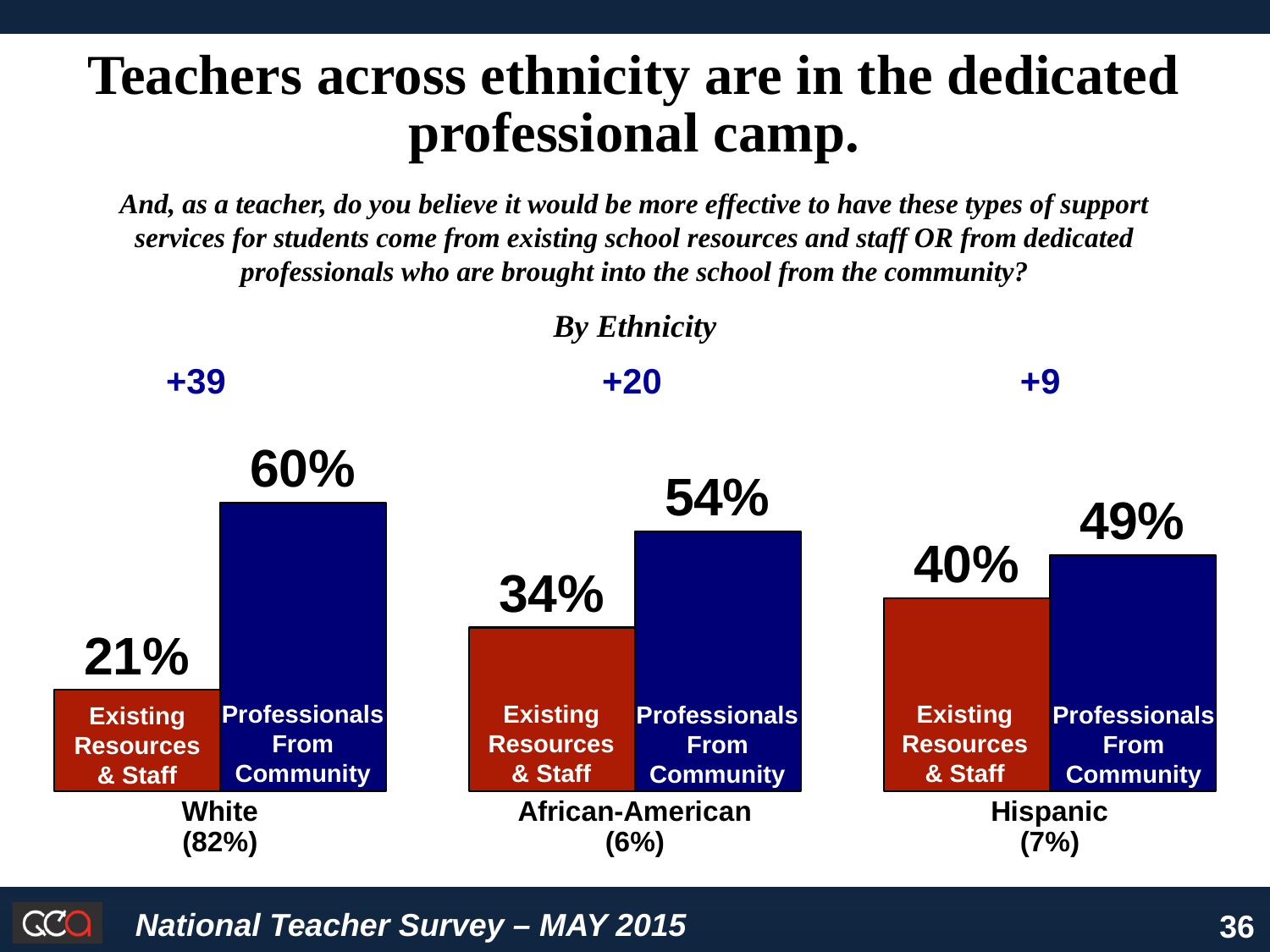
Which ethnicity group has the highest value for Professionals From Community? White What kind of chart is shown on the slide? Bar chart What percentage of African-American teachers chose Existing Resources & Staff? 34% How many ethnicity groups are shown in the chart? 3 What is the difference between Professionals From Community and Existing Resources & Staff for White teachers? 39 What percentage of White teachers chose Professionals From Community? 60% What colour are the Existing Resources & Staff bars? Red For Hispanic teachers, which is larger: Existing Resources & Staff or Professionals From Community? Professionals From Community What percentage of Hispanic teachers chose Existing Resources & Staff? 40% What is the difference between Professionals From Community and Existing Resources & Staff for African-American teachers? 20 Which ethnicity group has the lowest value for Existing Resources & Staff? White What percentage of Hispanic teachers chose Professionals From Community? 49%